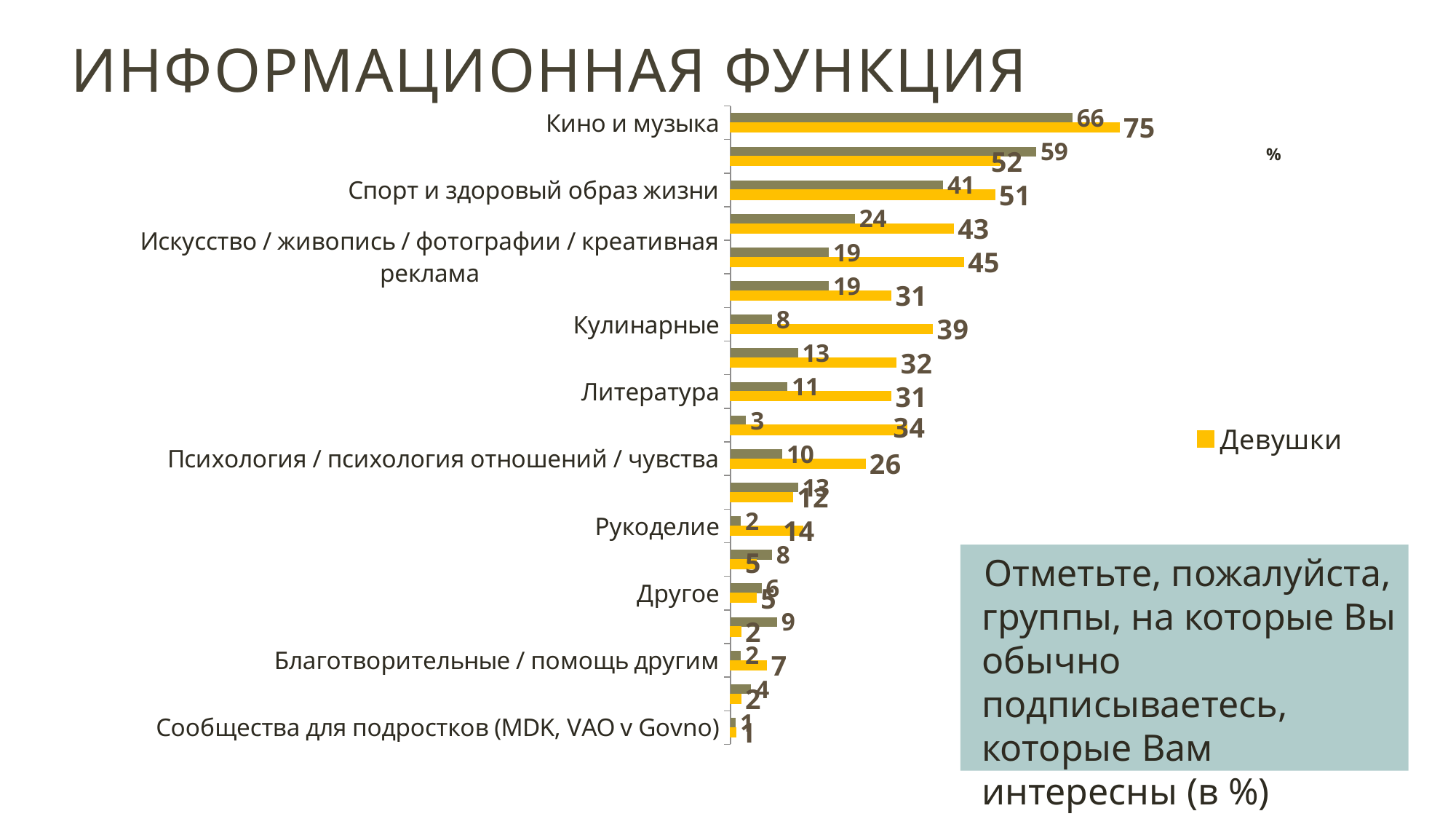
What is the value for Девушки for Спорт и здоровый образ жизни? 51 Which has the larger Девушки value: Литература or Психология / психология отношений / чувства? Литература What is the name of the series shown in the legend? Девушки How many series does the legend list? 1 For Кулинарные, what is the difference between the Девушки value and the olive-grey bar value? 31 For Кино и музыка, how much larger is the Девушки value than the olive-grey bar value? 9 What is the value for Девушки for Кино и музыка? 75 What kind of chart is shown on the slide? Bar chart What is the value for Девушки for Рукоделие? 14 What is the value of the olive-grey bar (the series not named in the legend) for Кино и музыка? 66 Which labelled category has the highest value for Девушки? Кино и музыка What is the value for Девушки for Кулинарные? 39